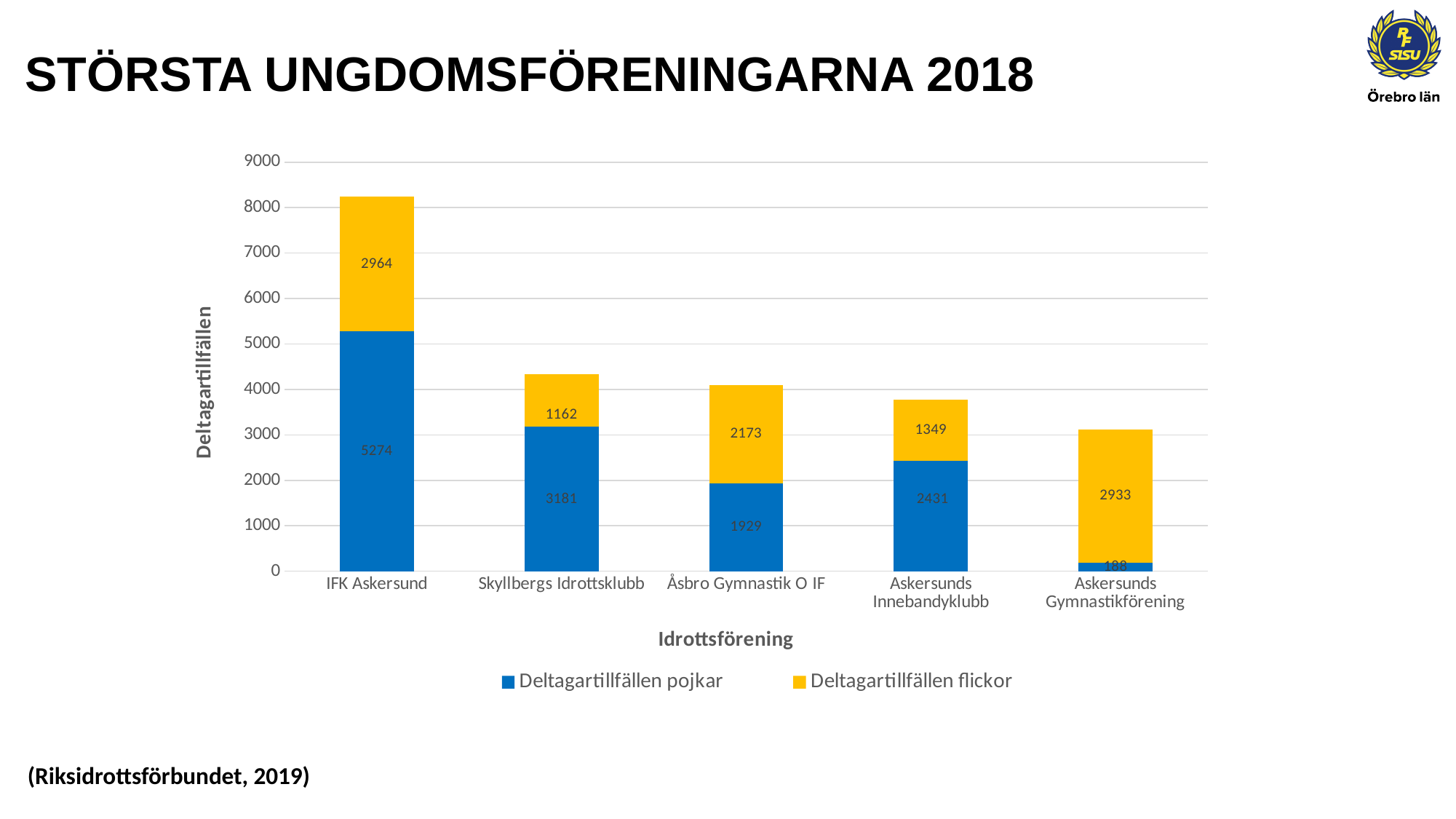
Which club has the lowest value for Deltagartillfällen pojkar? Askersunds Gymnastikförening Which club has the highest value for Deltagartillfällen pojkar? IFK Askersund How many series does the legend list? 2 What is the value of Deltagartillfällen flickor for Askersunds Gymnastikförening? 2933 Which is larger for Åsbro Gymnastik O IF: Deltagartillfällen pojkar or Deltagartillfällen flickor? Deltagartillfällen flickor What is the value of Deltagartillfällen pojkar for IFK Askersund? 5274 What is the value of Deltagartillfällen flickor for Skyllbergs Idrottsklubb? 1162 What kind of chart is shown on the slide? Stacked bar chart What is the total of the stacked bar for IFK Askersund? 8238 How many sports clubs (categories) are shown on the x axis? 5 What is the label of the y axis? Deltagartillfällen What is the difference between Deltagartillfällen pojkar and Deltagartillfällen flickor for Askersunds Innebandyklubb? 1082